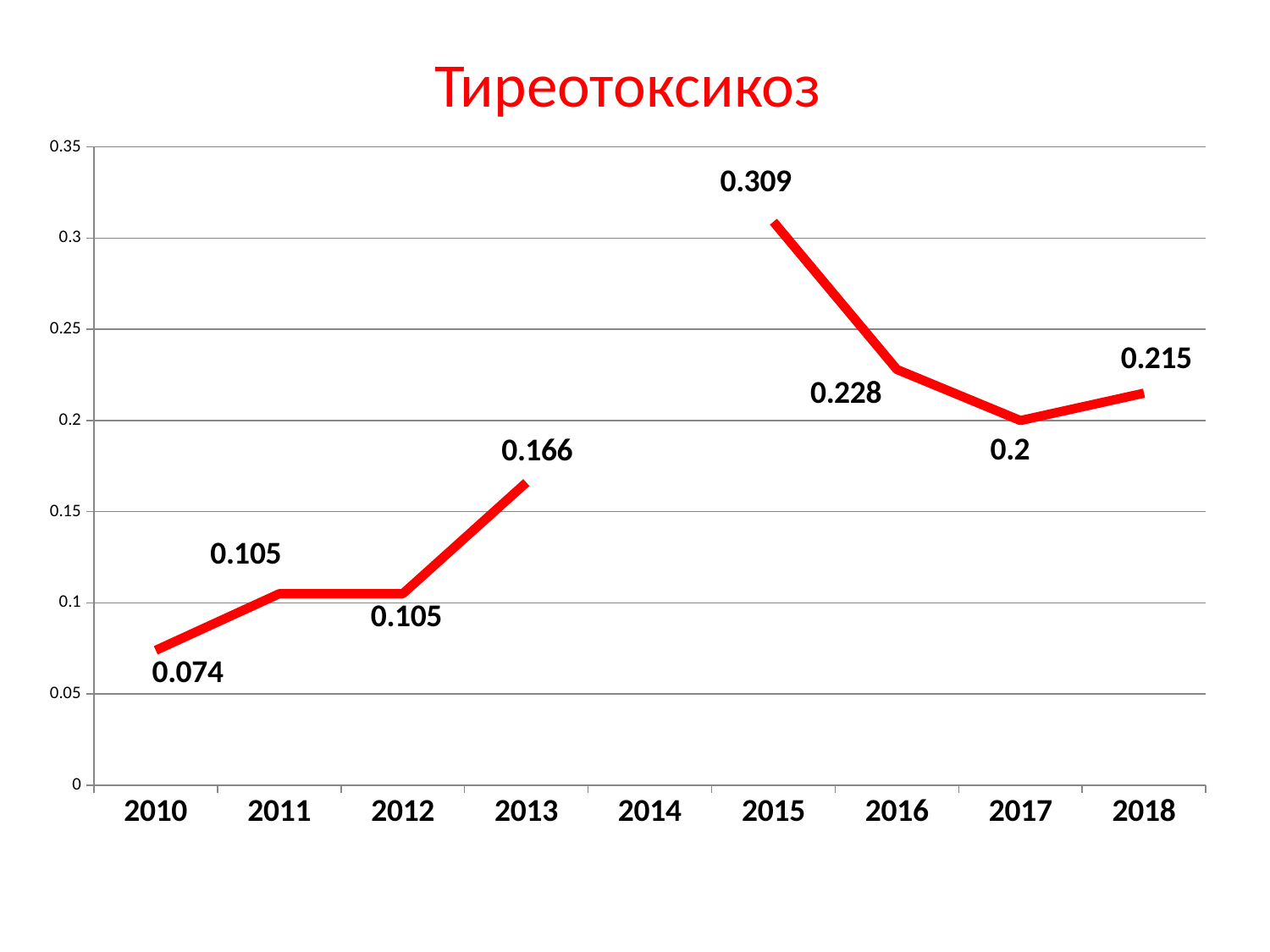
What is the value for 2010? 0.074 How many years are labelled on the x axis? 9 What is the value for 2013? 0.166 Is the value for 2015 greater or less than 0.3? greater What is the value for 2015? 0.309 Do the values rise or fall from 2010 to 2013? rise Which year has the lowest value? 2010 Which is larger, the value for 2018 or the value for 2016? 2016 What is the difference between the values for 2015 and 2016? 0.081 What is the value for 2017? 0.2 What kind of chart is shown? line chart Which year has the highest value? 2015